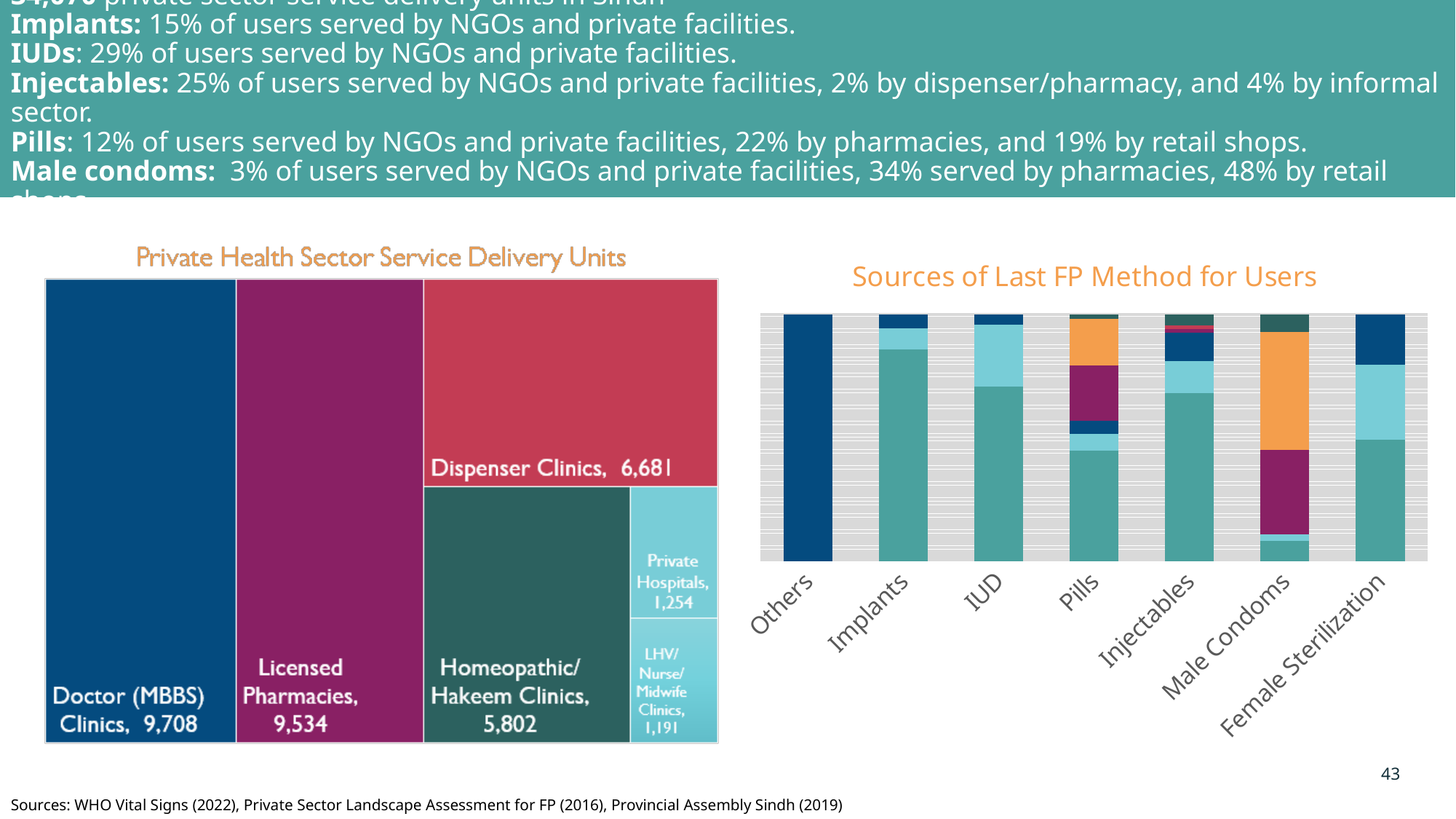
In the Private Health Sector Service Delivery Units chart, what is the value for Homeopathic/Hakeem Clinics? 5,802 In the Private Health Sector Service Delivery Units chart, how many Doctor (MBBS) Clinics are shown? 9,708 How many categories are shown in the Private Health Sector Service Delivery Units chart? 6 In the Private Health Sector Service Delivery Units chart, what is the difference between Dispenser Clinics and Homeopathic/Hakeem Clinics? 879 How many categories are shown on the x axis of the Sources of Last FP Method for Users chart? 7 In the Private Health Sector Service Delivery Units chart, which category has the highest value? Doctor (MBBS) Clinics In the Private Health Sector Service Delivery Units chart, what is the difference between Doctor (MBBS) Clinics and Licensed Pharmacies? 174 In the Private Health Sector Service Delivery Units chart, which is larger: Private Hospitals or LHV/Nurse/Midwife Clinics? Private Hospitals In the Private Health Sector Service Delivery Units chart, which category has the lowest value? LHV/Nurse/Midwife Clinics What kind of chart is the Sources of Last FP Method for Users chart? Stacked bar chart In the Private Health Sector Service Delivery Units chart, what is the value for Dispenser Clinics? 6,681 In the Private Health Sector Service Delivery Units chart, what is the value for Licensed Pharmacies? 9,534